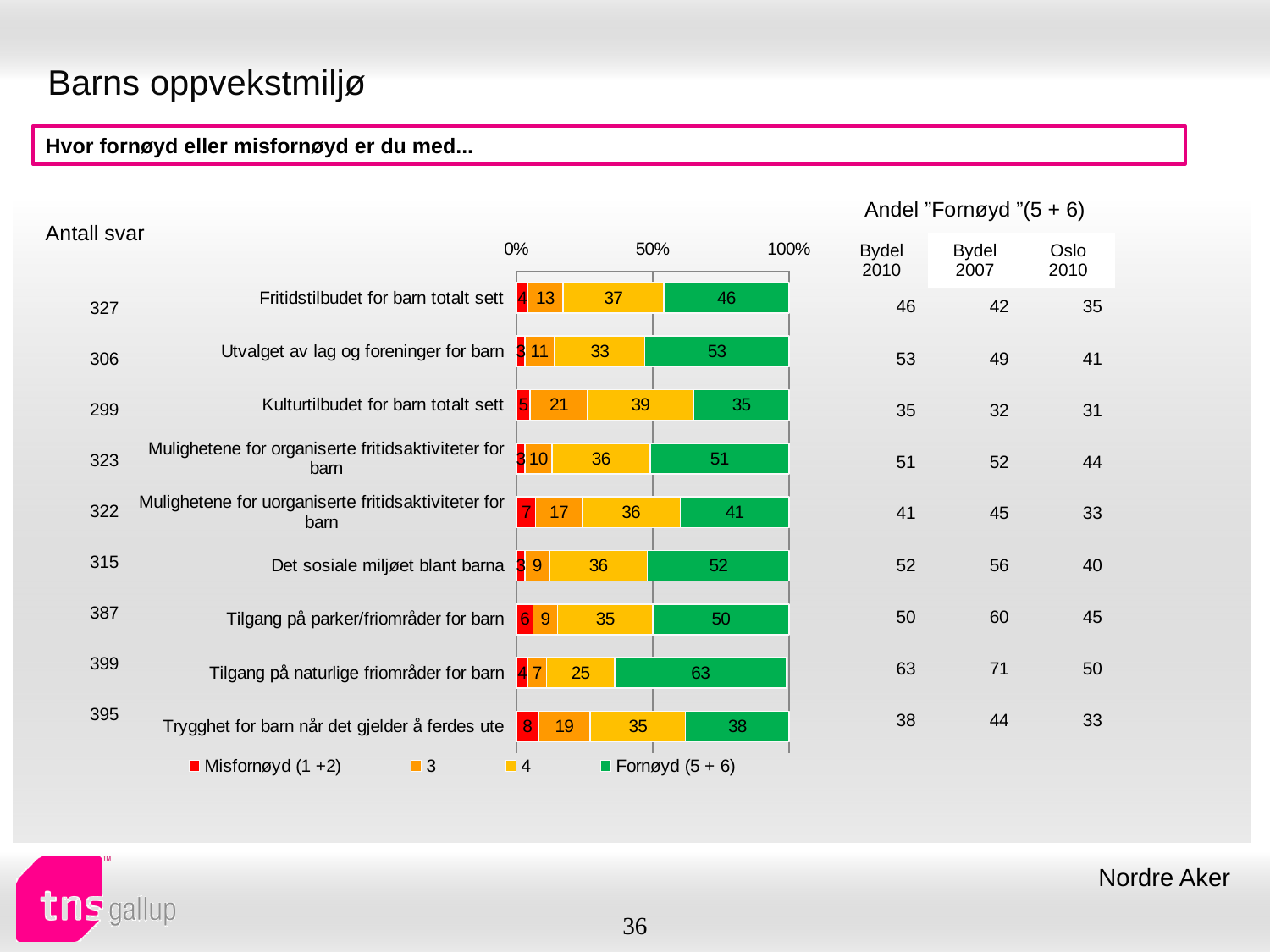
Which category has the highest 'Fornøyd (5 + 6)' value? Tilgang på naturlige friområder for barn How many categories are plotted in the chart? 9 How many series does the chart legend list? 4 What is the 'Fornøyd (5 + 6)' value for 'Tilgang på naturlige friområder for barn'? 63 Which series in the legend is shown in green? Fornøyd (5 + 6) What is the total of the stacked bar for 'Tilgang på parker/friområder for barn'? 100 What is the 'Misfornøyd (1 +2)' value for 'Trygghet for barn når det gjelder å ferdes ute'? 8 Which category has the lowest 'Fornøyd (5 + 6)' value? Kulturtilbudet for barn totalt sett What is the '3' value for 'Kulturtilbudet for barn totalt sett'? 21 What is the difference between the 'Fornøyd (5 + 6)' values for 'Utvalget av lag og foreninger for barn' and 'Fritidstilbudet for barn totalt sett'? 7 Which has a larger 'Fornøyd (5 + 6)' value: 'Det sosiale miljøet blant barna' or 'Mulighetene for uorganiserte fritidsaktiviteter for barn'? Det sosiale miljøet blant barna What type of chart is shown on the slide? Stacked bar chart